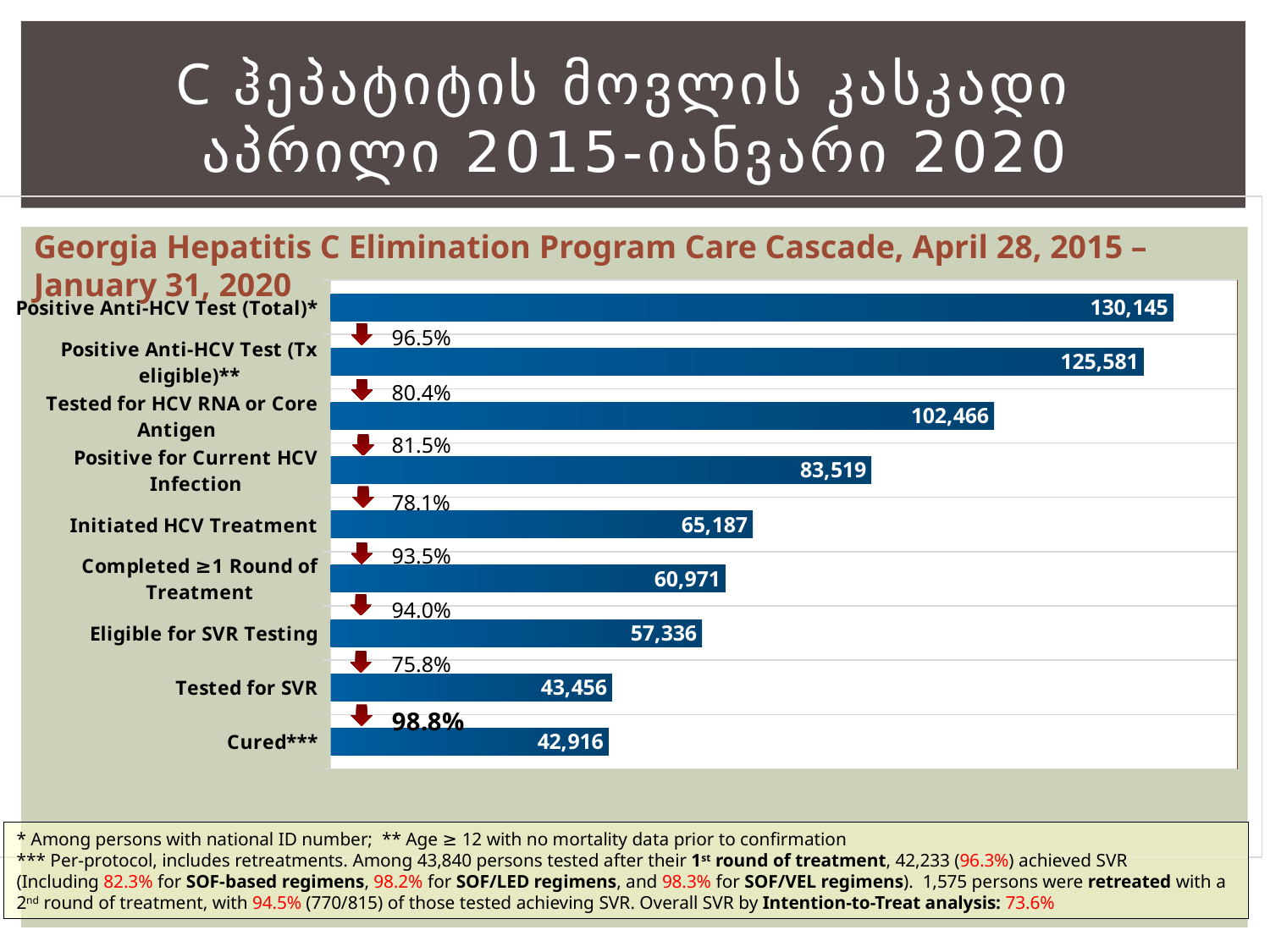
What is the difference between Positive Anti-HCV Test (Total)* and Positive Anti-HCV Test (Tx eligible)**? 4,564 Which category has the highest value? Positive Anti-HCV Test (Total)* What kind of chart is shown on the slide? Bar chart Which category has the lowest value? Cured*** What is the value for Positive Anti-HCV Test (Total)*? 130,145 What is the difference between Tested for SVR and Cured***? 540 What percentage is shown between Tested for SVR and Cured***? 98.8% What is the value for Cured***? 42,916 What is the value for Initiated HCV Treatment? 65,187 What is the value for Tested for HCV RNA or Core Antigen? 102,466 How many categories are shown in the chart? 9 Which is larger, Eligible for SVR Testing or Completed ≥1 Round of Treatment? Completed ≥1 Round of Treatment